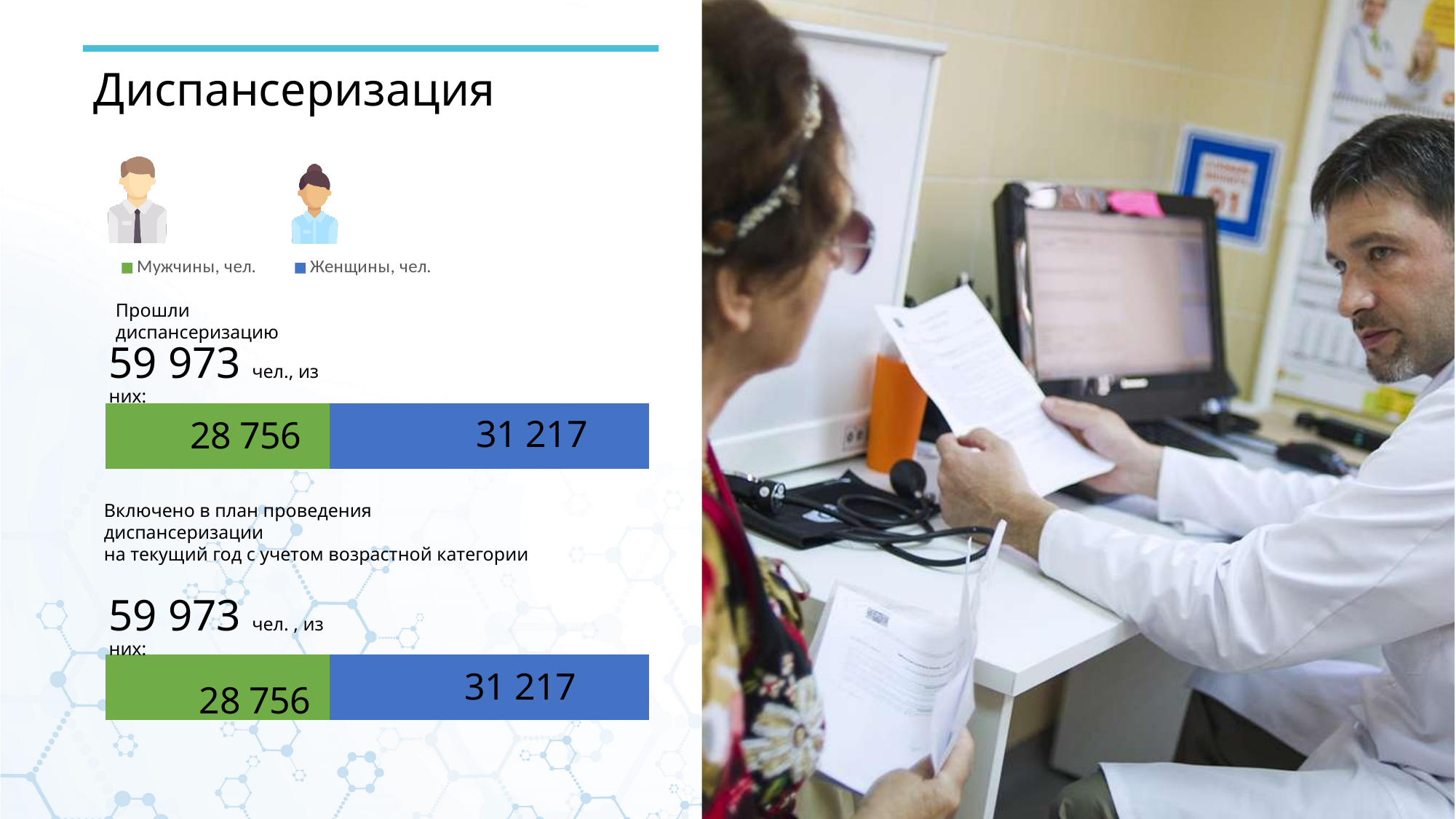
In the upper chart (Прошли диспансеризацию), which group is larger, Мужчины or Женщины? Женщины In the upper chart (Прошли диспансеризацию), what is the total number of people shown? 59 973 What kind of chart is used in the upper chart (Прошли диспансеризацию)? Stacked bar chart In the upper chart (Прошли диспансеризацию), what is the value for Мужчины? 28 756 What is the title of the slide? Диспансеризация Which colour represents Мужчины in the legend? Green In the lower chart (Включено в план проведения диспансеризации), what is the value for Мужчины? 28 756 In the upper chart (Прошли диспансеризацию), what is the value for Женщины? 31 217 In the upper chart (Прошли диспансеризацию), what is the difference between the Женщины and Мужчины values? 2 461 In the lower chart (Включено в план проведения диспансеризации), what is the total of the stacked bar? 59 973 How many series does the legend list? 2 In the lower chart (Включено в план проведения диспансеризации), what is the value for Женщины? 31 217